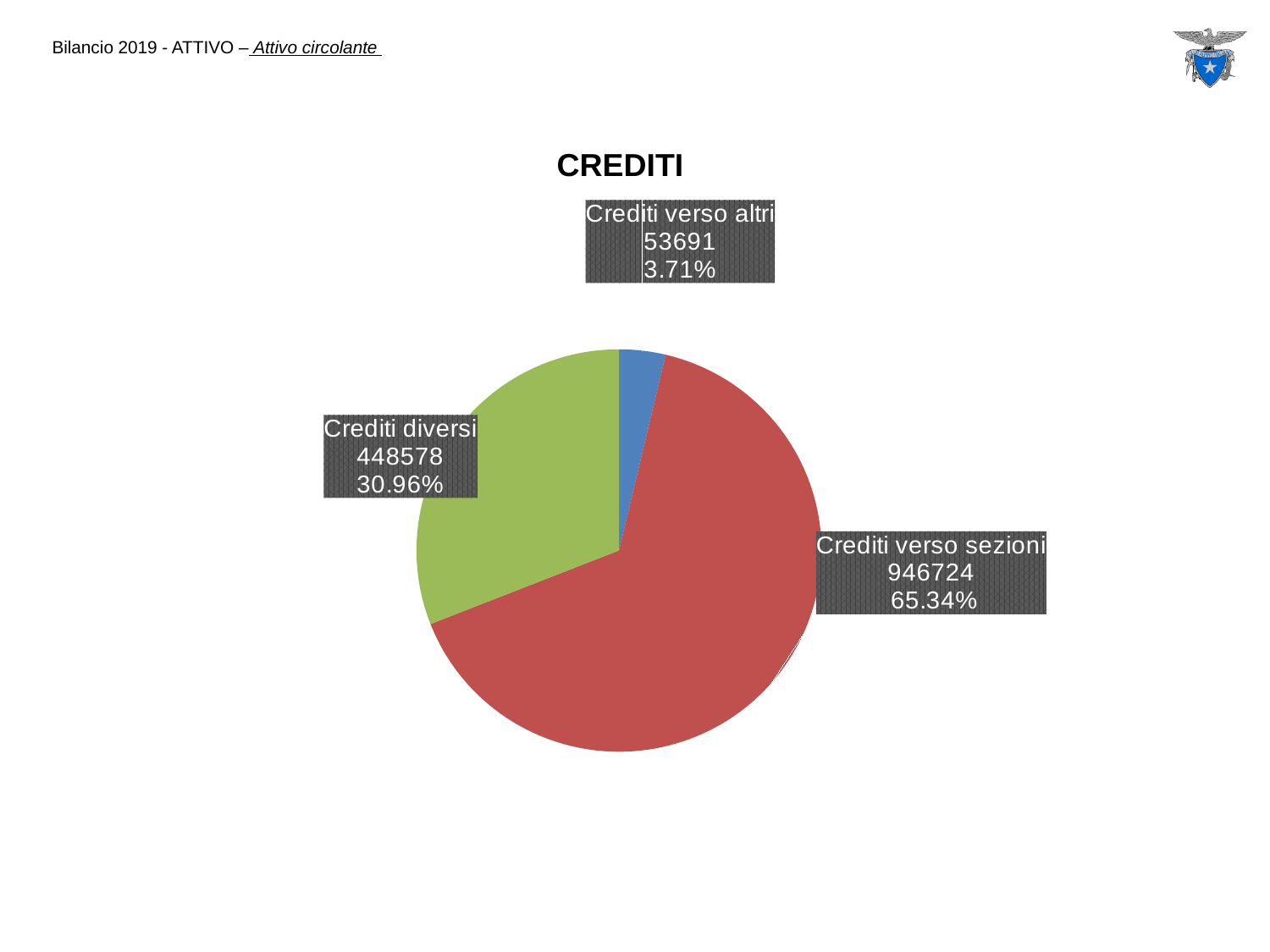
What is the difference between the values for Crediti verso sezioni and Crediti diversi? 498146 What share of the pie does Crediti verso sezioni represent? 65.34% What is the value for Crediti diversi? 448578 Which category has the largest slice? Crediti verso sezioni What is the value for Crediti verso altri? 53691 What share of the pie does Crediti diversi represent? 30.96% What type of chart is shown? Pie chart What share of the pie does Crediti verso altri represent? 3.71% What is the value for Crediti verso sezioni? 946724 Which is larger, Crediti diversi or Crediti verso altri? Crediti diversi How many slices does the pie chart have? 3 Which category has the smallest slice? Crediti verso altri